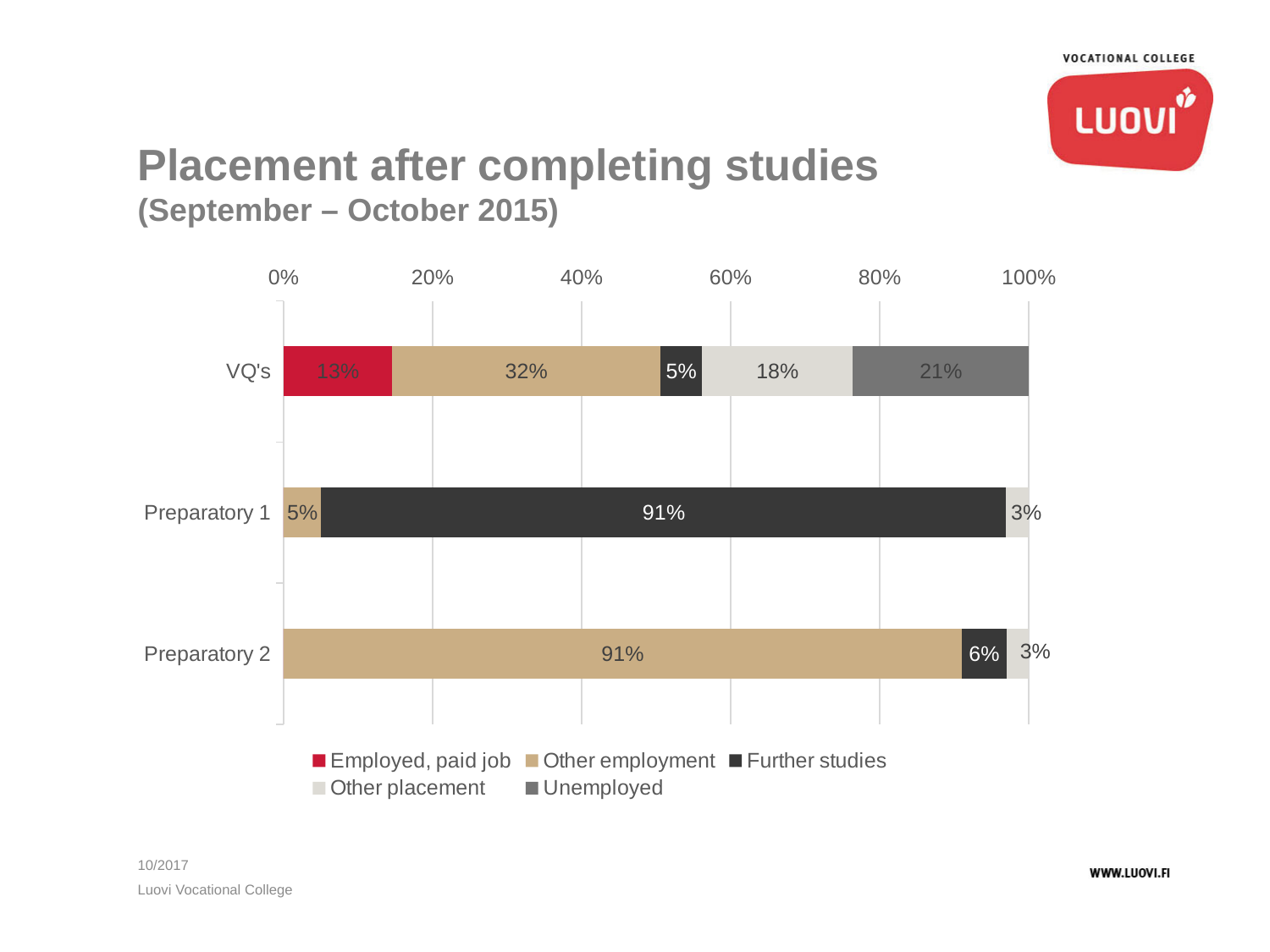
How many study groups are shown on the chart? 3 What is the Further studies value for Preparatory 1? 91% What is the total of the Preparatory 2 bar? 100% What is the Further studies value for Preparatory 2? 6% For VQ's, what is the difference between the Unemployed share and the Other placement share? 3% How many series does the legend list? 5 What is the Unemployed share for VQ's? 21% What is the Other placement value for Preparatory 2? 3% What kind of chart is shown on the slide? Stacked bar chart For VQ's, which is larger: Employed, paid job or Further studies? Employed, paid job Which placement category has the largest share for VQ's? Other employment What percentage of VQ's graduates are in other employment? 32%